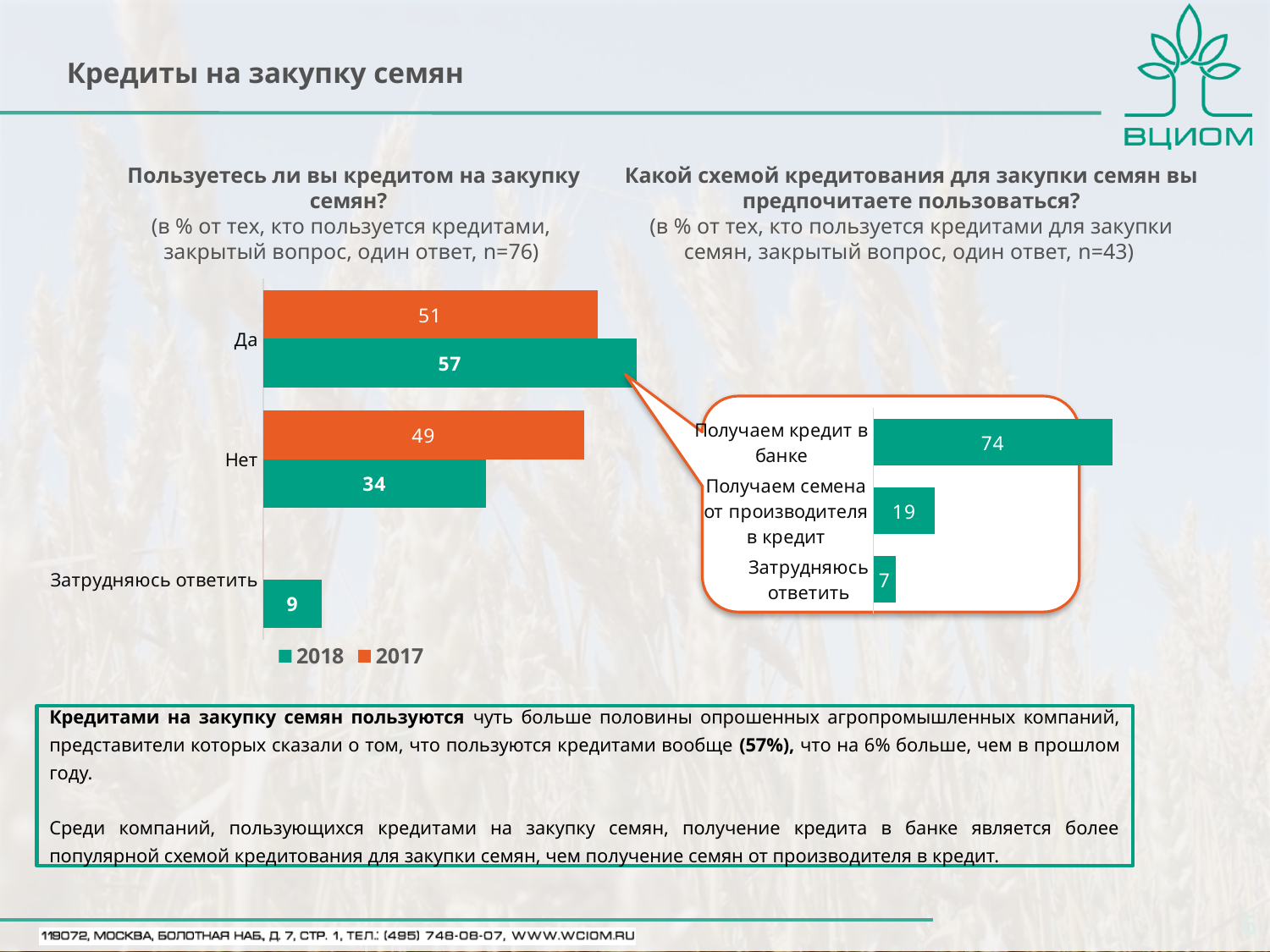
In the right chart 'Какой схемой кредитования для закупки семян вы предпочитаете пользоваться?', what is the difference between 'Получаем кредит в банке' and 'Получаем семена от производителя в кредит'? 55 In the left chart 'Пользуетесь ли вы кредитом на закупку семян?', what is the 2017 value for 'Нет'? 49 In the left chart 'Пользуетесь ли вы кредитом на закупку семян?', how many series does the legend list? 2 In the left chart 'Пользуетесь ли вы кредитом на закупку семян?', what is the 2018 value for 'Затрудняюсь ответить'? 9 In the left chart 'Пользуетесь ли вы кредитом на закупку семян?', what is the difference between the 2018 and 2017 values for 'Да'? 6 In the left chart 'Пользуетесь ли вы кредитом на закупку семян?', what is the 2018 value for 'Да'? 57 In the right chart 'Какой схемой кредитования для закупки семян вы предпочитаете пользоваться?', what is the value for 'Получаем кредит в банке'? 74 In the left chart 'Пользуетесь ли вы кредитом на закупку семян?', which category has the lowest 2018 value? Затрудняюсь ответить In the left chart 'Пользуетесь ли вы кредитом на закупку семян?', which is larger for 'Нет': the 2017 value or the 2018 value? 2017 In the right chart 'Какой схемой кредитования для закупки семян вы предпочитаете пользоваться?', which category has the highest value? Получаем кредит в банке What kind of chart is the left chart 'Пользуетесь ли вы кредитом на закупку семян?'? Bar chart How many categories are shown in the right chart 'Какой схемой кредитования для закупки семян вы предпочитаете пользоваться?'? 3